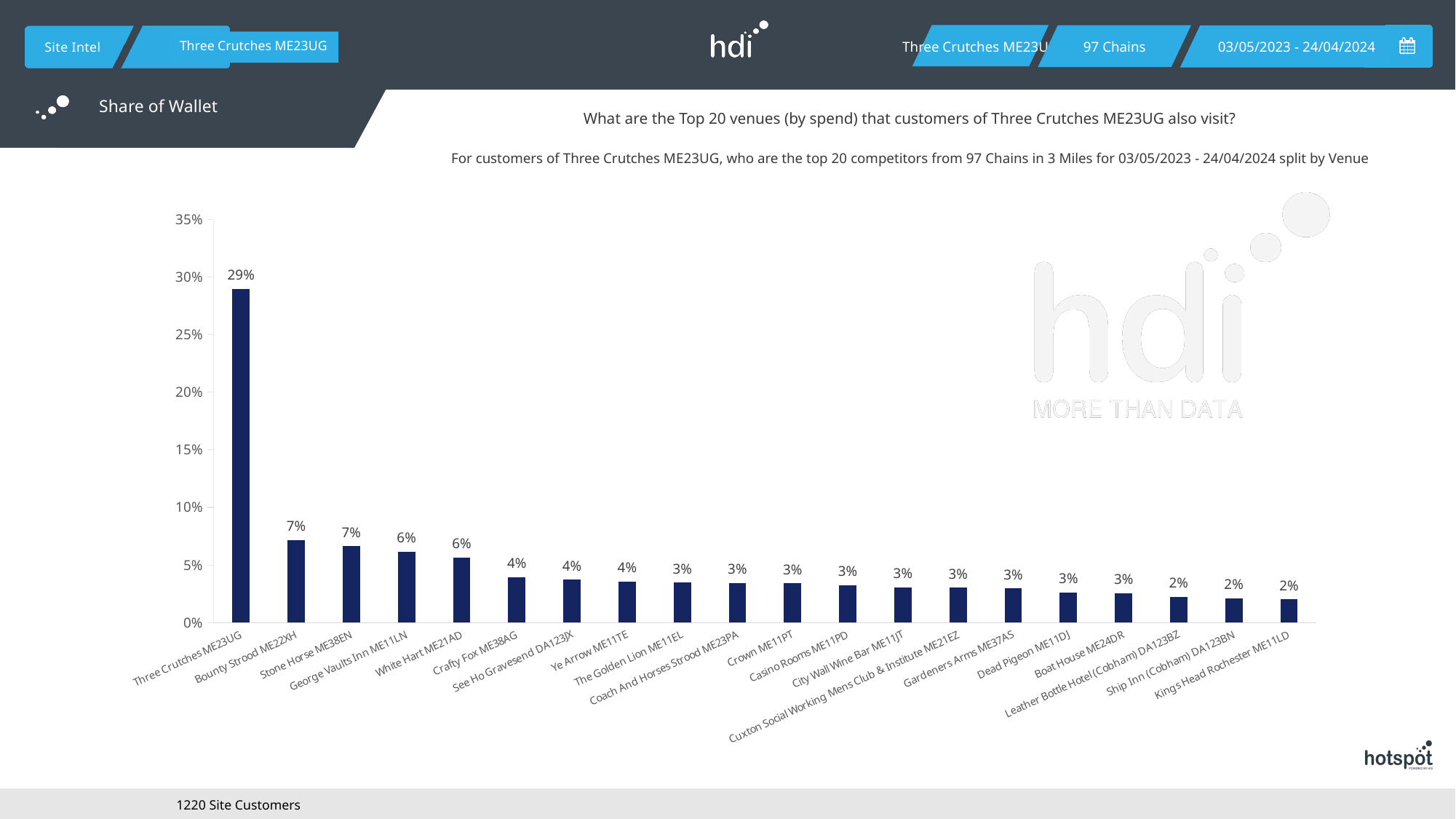
What is the value shown for White Hart ME21AD? 6% What is the difference between the values for Three Crutches ME23UG and Bounty Strood ME22XH? 22% How many venues are plotted in the chart? 20 What is the value shown for Bounty Strood ME22XH? 7% Is the value for Three Crutches ME23UG greater or less than 25%? greater What kind of chart is shown on the slide? bar chart Do the values generally rise or fall moving from left to right along the x axis? fall What is the value shown for Three Crutches ME23UG? 29% What is the value shown for Kings Head Rochester ME11LD? 2% What is the value shown for Crafty Fox ME38AG? 4% Which is larger, the value for George Vaults Inn ME11LN or the value for Ye Arrow ME11TE? George Vaults Inn ME11LN Which venue has the highest share of wallet in the chart? Three Crutches ME23UG